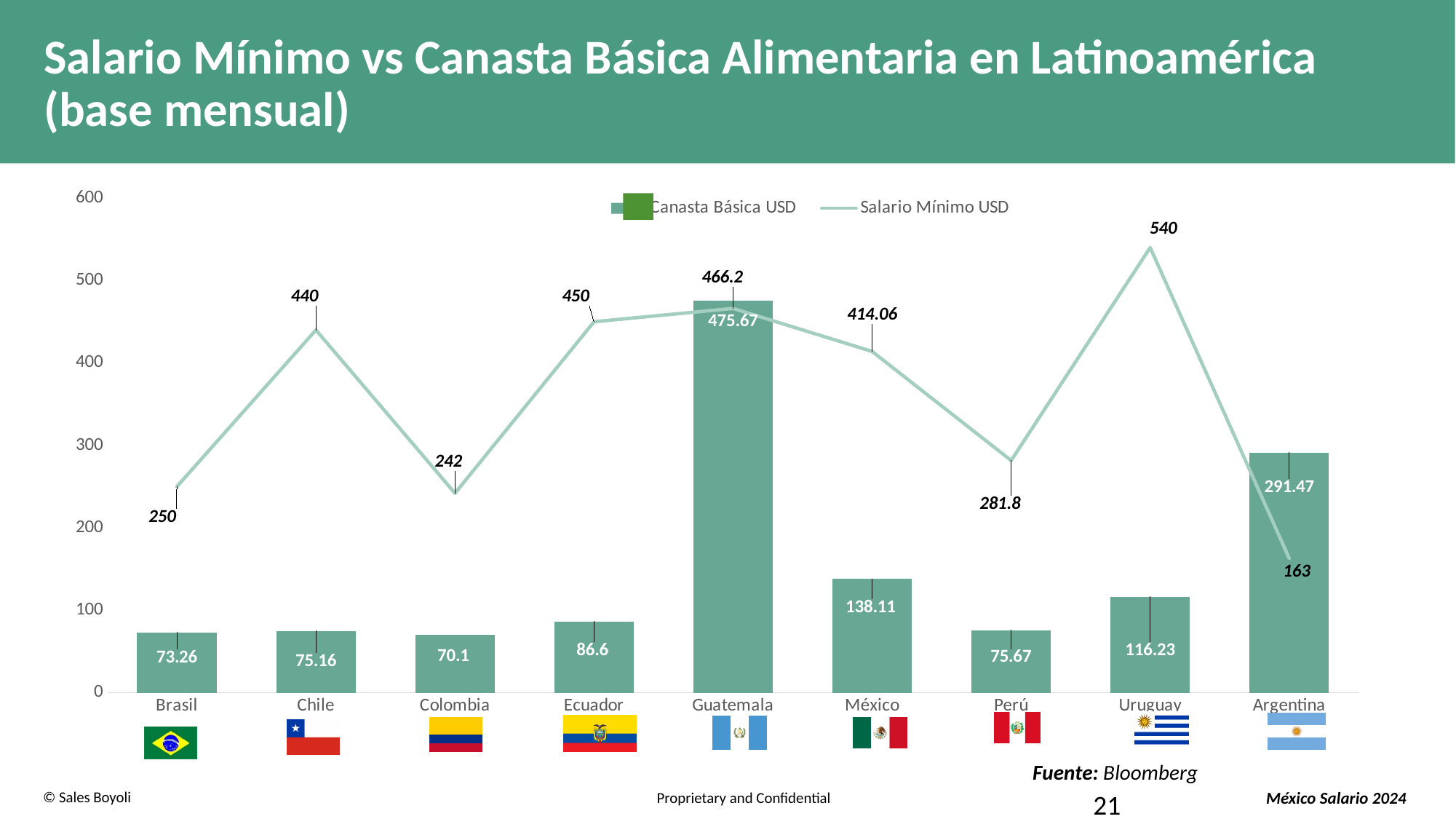
Which country has the highest Salario Mínimo USD? Uruguay What kind of chart is shown on the slide? Combined bar and line chart Which country has the lowest Canasta Básica USD? Colombia What is the Canasta Básica USD value for Guatemala? 475.67 What is the Salario Mínimo USD value for Uruguay? 540 Which country has the lowest Salario Mínimo USD? Argentina How many series does the legend list? 2 What is the difference between the Salario Mínimo USD and the Canasta Básica USD for Argentina? 128.47 How many countries are shown on the x axis? 9 What is the Canasta Básica USD value for México? 138.11 What is the Salario Mínimo USD value for Colombia? 242 Which is larger for Guatemala, the Canasta Básica USD or the Salario Mínimo USD? Canasta Básica USD